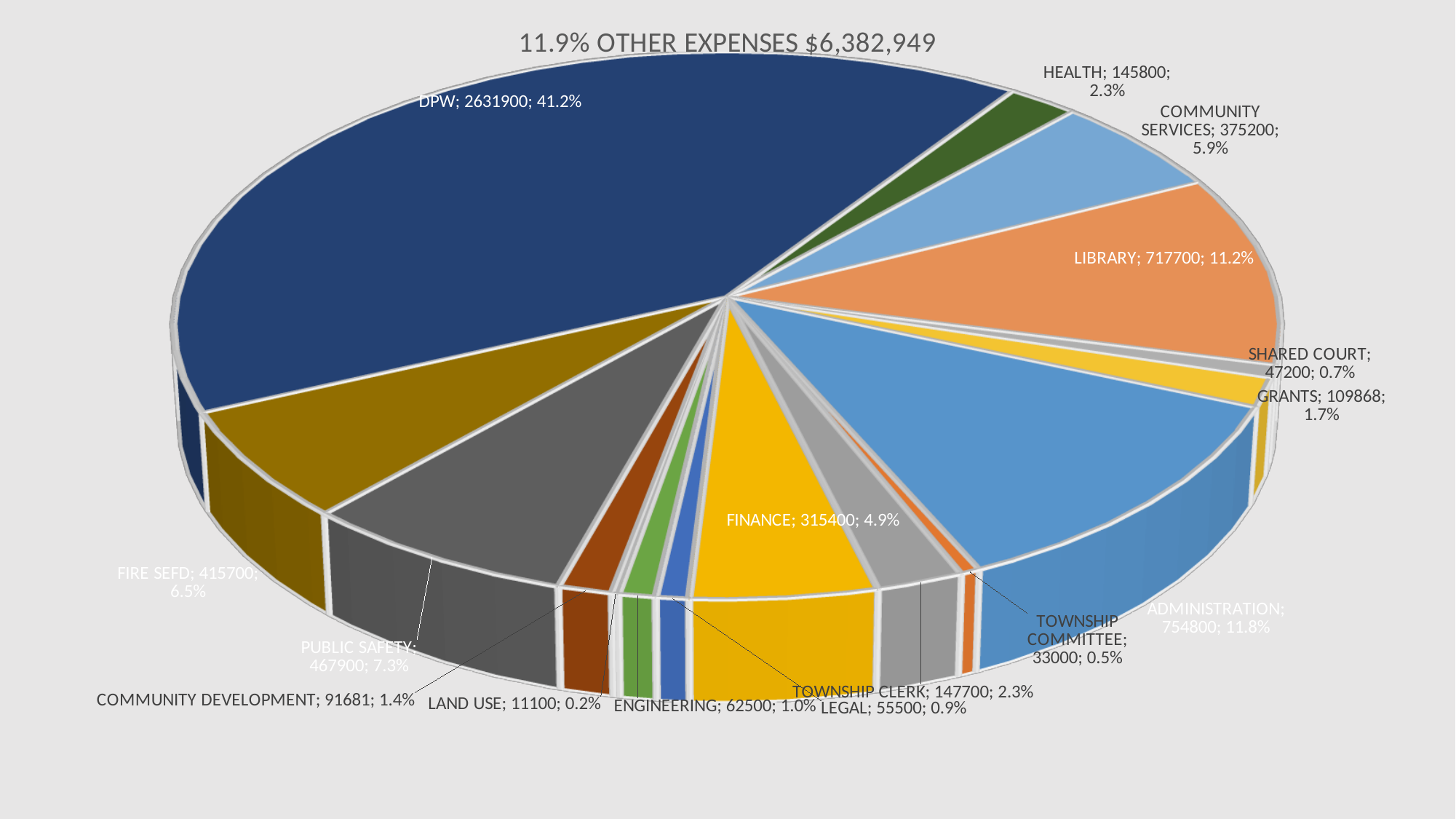
What share of the pie does FIRE SEFD represent? 6.5% Which category has the smallest slice? LAND USE What is the title of the chart? 11.9% OTHER EXPENSES $6,382,949 What share of the pie does ADMINISTRATION represent? 11.8% What kind of chart is shown on the slide? Pie chart Which category has the largest slice? DPW How many categories are shown in the pie chart? 16 What is the value for LIBRARY? 717700 What is the difference between the values for ADMINISTRATION and LIBRARY? 37100 What is the value for GRANTS? 109868 Which is larger, the value for COMMUNITY SERVICES or the value for FINANCE? COMMUNITY SERVICES What is the value for PUBLIC SAFETY? 467900